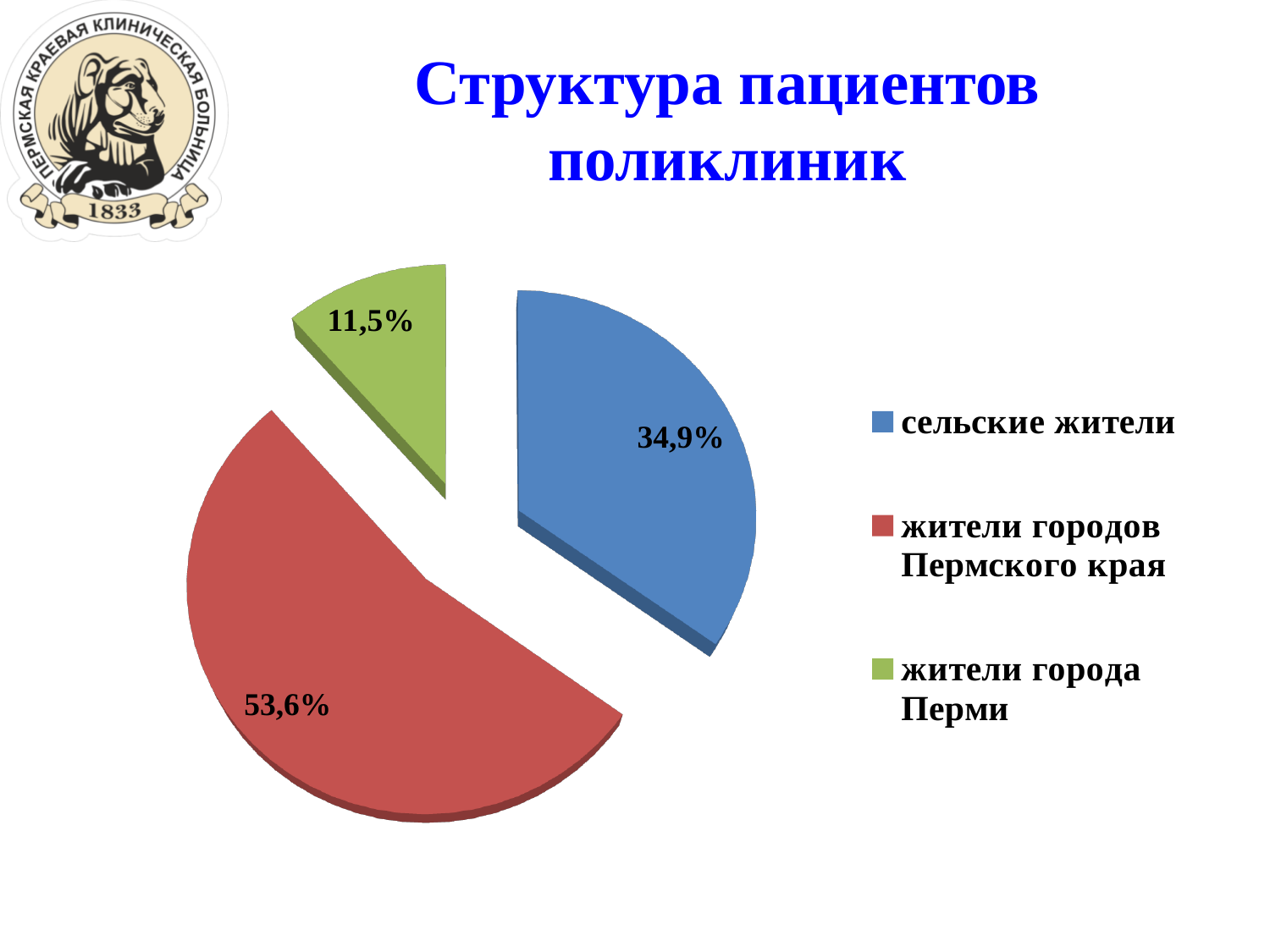
What colour is the slice for жители городов Пермского края? red Which category has the smallest share of the pie? жители города Перми Which is larger: the share for сельские жители or the share for жители города Перми? сельские жители Which category has the largest share of the pie? жители городов Пермского края What share of patients are сельские жители? 34,9% How many entries does the legend list? 3 What share of patients are жители города Перми? 11,5% How many slices does the pie chart have? 3 What is the title of the chart? Структура пациентов поликлиник What share of patients are жители городов Пермского края? 53,6% What kind of chart is shown on the slide? pie chart What is the difference in percentage points between жители городов Пермского края and сельские жители? 18,7